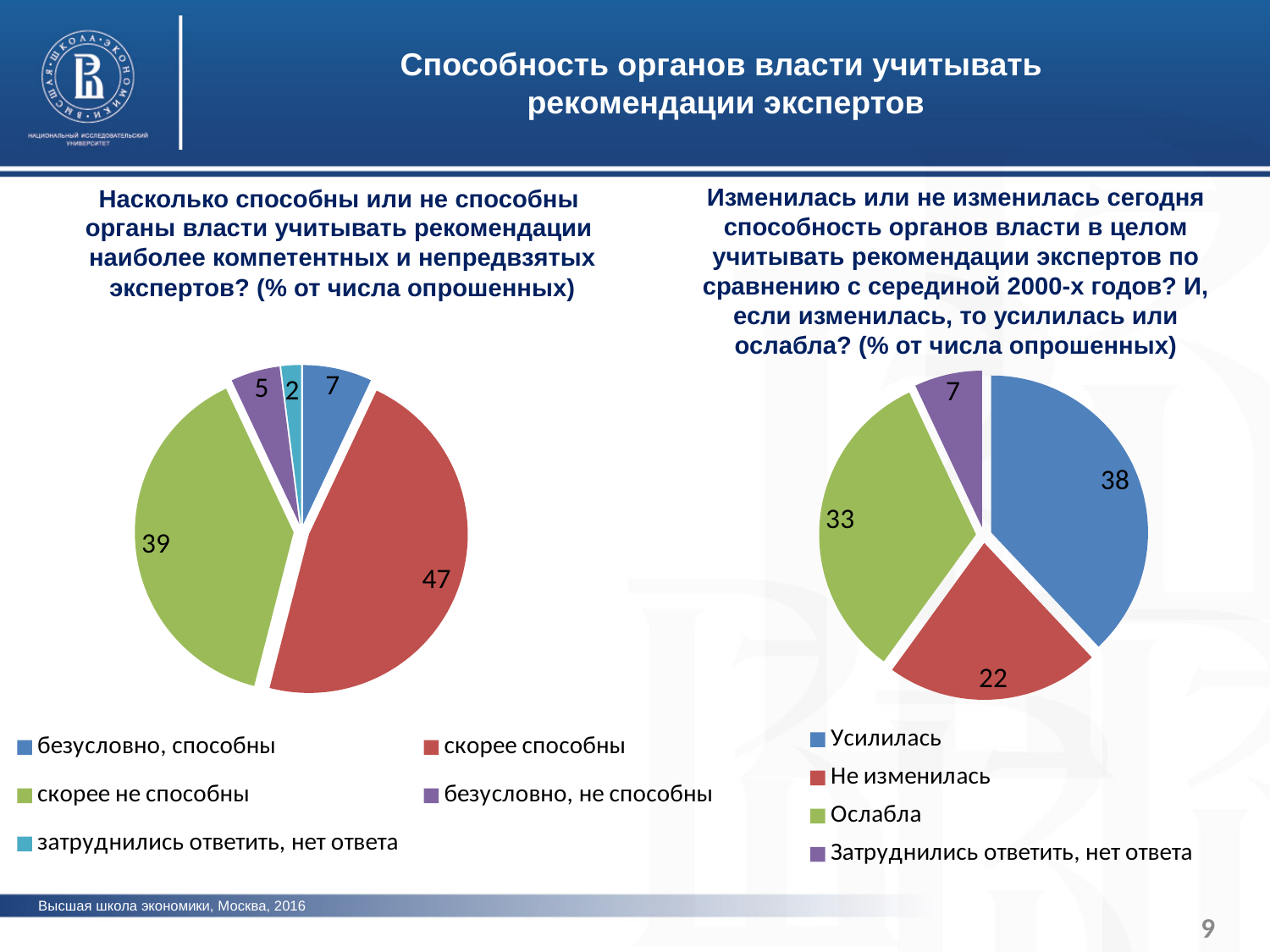
On the left pie chart, which category has the smallest slice? затруднились ответить, нет ответа On the right pie chart, which is larger: «Усилилась» or «Ослабла»? Усилилась On the left pie chart, which category has the largest slice? скорее способны On the left pie chart, what is the value for «скорее способны»? 47 On the right pie chart, what is the difference between «Усилилась» and «Не изменилась»? 16 On the right pie chart, which category has the largest slice? Усилилась On the left pie chart, what is the difference between «скорее способны» and «скорее не способны»? 8 On the right pie chart, what is the value for «Ослабла»? 33 How many categories does the legend of the left pie chart list? 5 On the right pie chart, what is the value for «Не изменилась»? 22 On the left pie chart, what is the value for «безусловно, не способны»? 5 What type of chart is used on the right side of the slide? pie chart